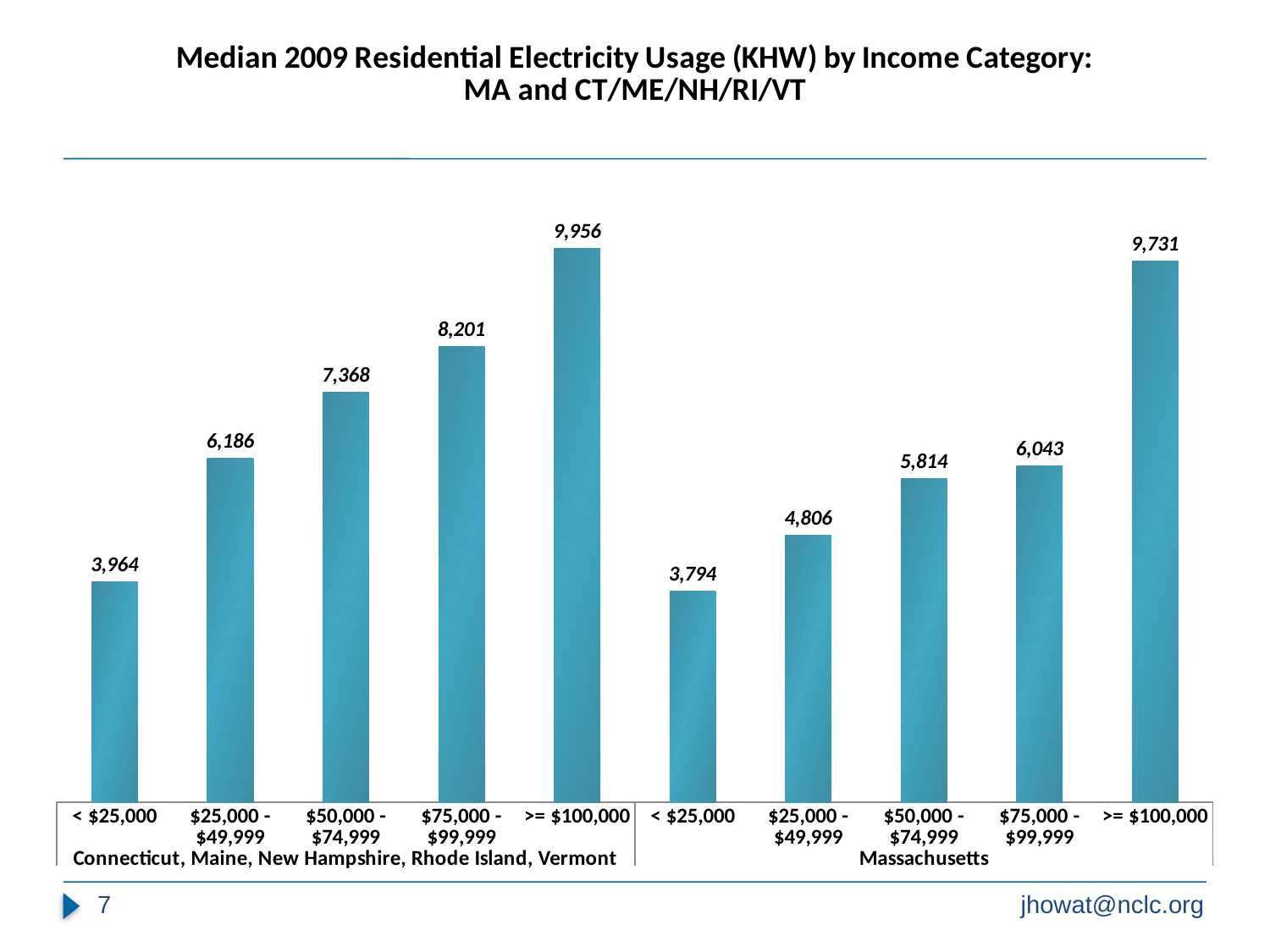
Which bar has the highest value on the chart? >= $100,000 in Connecticut, Maine, New Hampshire, Rhode Island, Vermont What is the difference between the >= $100,000 values for the CT/ME/NH/RI/VT group and Massachusetts? 225 What is the title of the chart? Median 2009 Residential Electricity Usage (KHW) by Income Category: MA and CT/ME/NH/RI/VT What is the median electricity usage for the < $25,000 income category in Massachusetts? 3,794 What is the difference between the $75,000 - $99,999 and $50,000 - $74,999 values in Massachusetts? 229 What is the median electricity usage for the >= $100,000 income category in Connecticut, Maine, New Hampshire, Rhode Island, Vermont? 9,956 Within the Massachusetts group, do the values rise or fall as income category increases? Rise Which bar has the lowest value on the chart? < $25,000 in Massachusetts What is the median electricity usage for the $50,000 - $74,999 income category in Massachusetts? 5,814 What kind of chart is shown on the slide? Bar chart How many bars are plotted on the chart? 10 Which is larger: the $25,000 - $49,999 value for CT/ME/NH/RI/VT or the $75,000 - $99,999 value for Massachusetts? $25,000 - $49,999 for CT/ME/NH/RI/VT